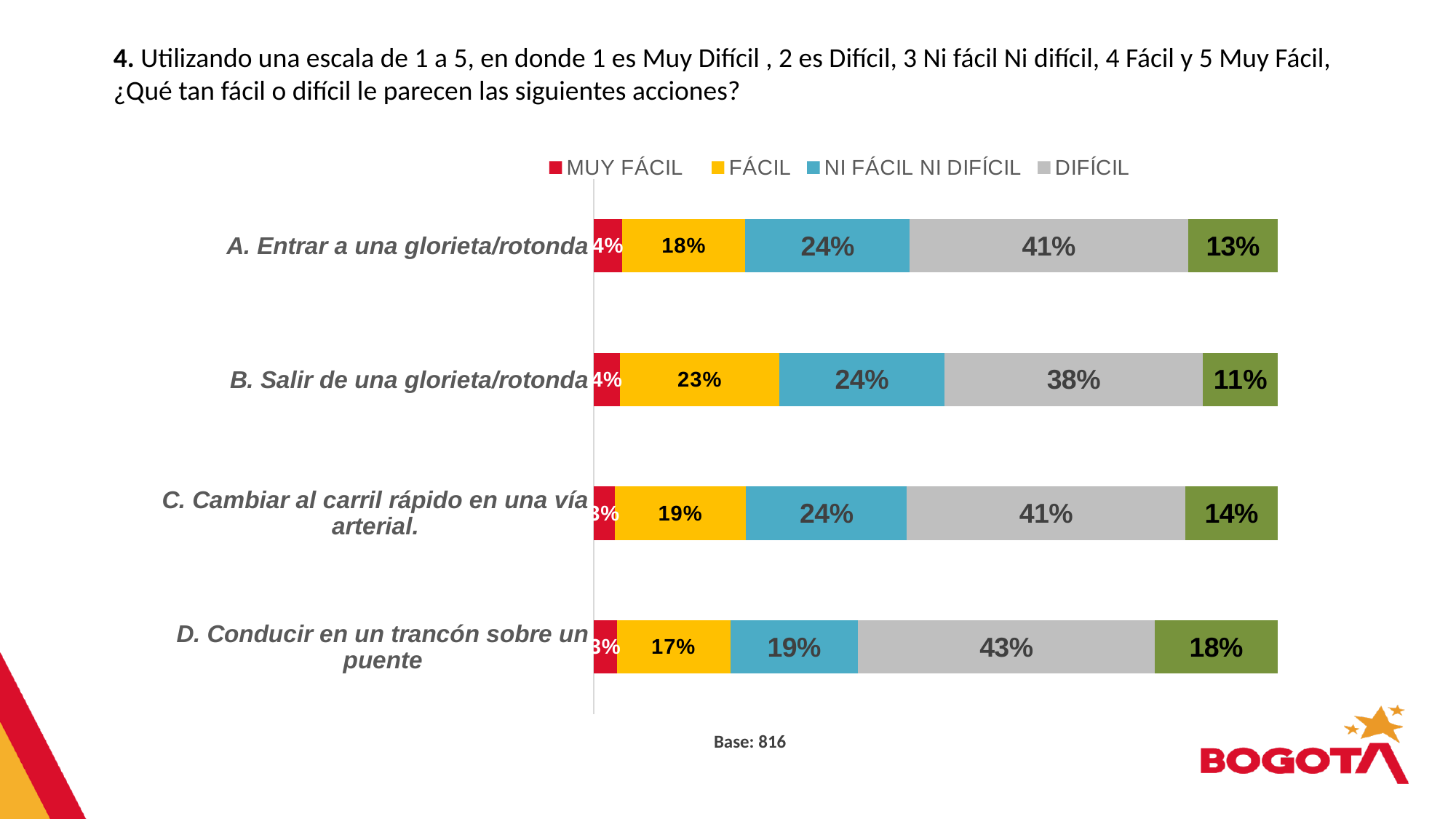
What is the difference between the DIFÍCIL values for action A and action B? 3 percentage points What is the NI FÁCIL NI DIFÍCIL value for 'D. Conducir en un trancón sobre un puente'? 19% What is the FÁCIL value for 'B. Salir de una glorieta/rotonda'? 23% Which has a larger FÁCIL value: action B or action C? B. Salir de una glorieta/rotonda What is the DIFÍCIL value for 'D. Conducir en un trancón sobre un puente'? 43% Which action has the highest DIFÍCIL percentage? D. Conducir en un trancón sobre un puente What type of chart is shown on the slide? Stacked bar chart How many actions (categories) are shown in the chart? 4 Which action has the lowest FÁCIL percentage? D. Conducir en un trancón sobre un puente What is the base (number of respondents) shown below the chart? 816 What percentage of respondents rated 'A. Entrar a una glorieta/rotonda' as DIFÍCIL? 41% How many series does the legend list? 4